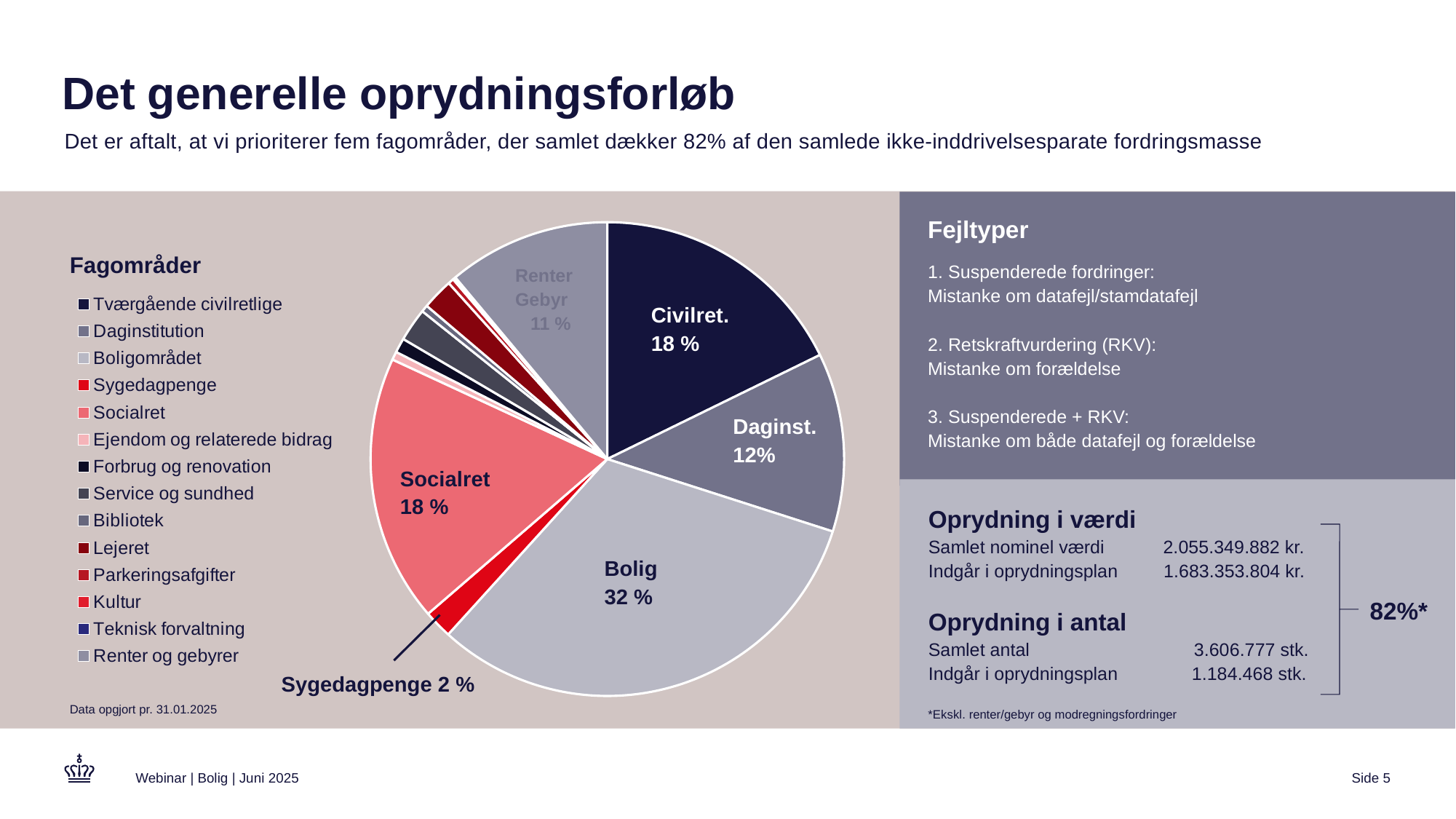
What is the title of the legend next to the pie chart? Fagområder What is the value shown for Daginst. in the pie chart? 12% What is the difference in percentage points between Bolig and Daginst. in the pie chart? 20 Which is larger in the pie chart, Bolig or Civilret.? Bolig What share of the pie does Bolig account for? 32 % What kind of chart is shown on the slide? pie chart What is the value shown for Renter Gebyr in the pie chart? 11 % Which is larger in the pie chart, Daginst. or Renter Gebyr? Daginst. What is the value shown for Civilret. in the pie chart? 18 % What is the value shown for Sygedagpenge in the pie chart? 2 % Which slice of the pie chart is the largest? Bolig How many entries does the Fagområder legend list? 14